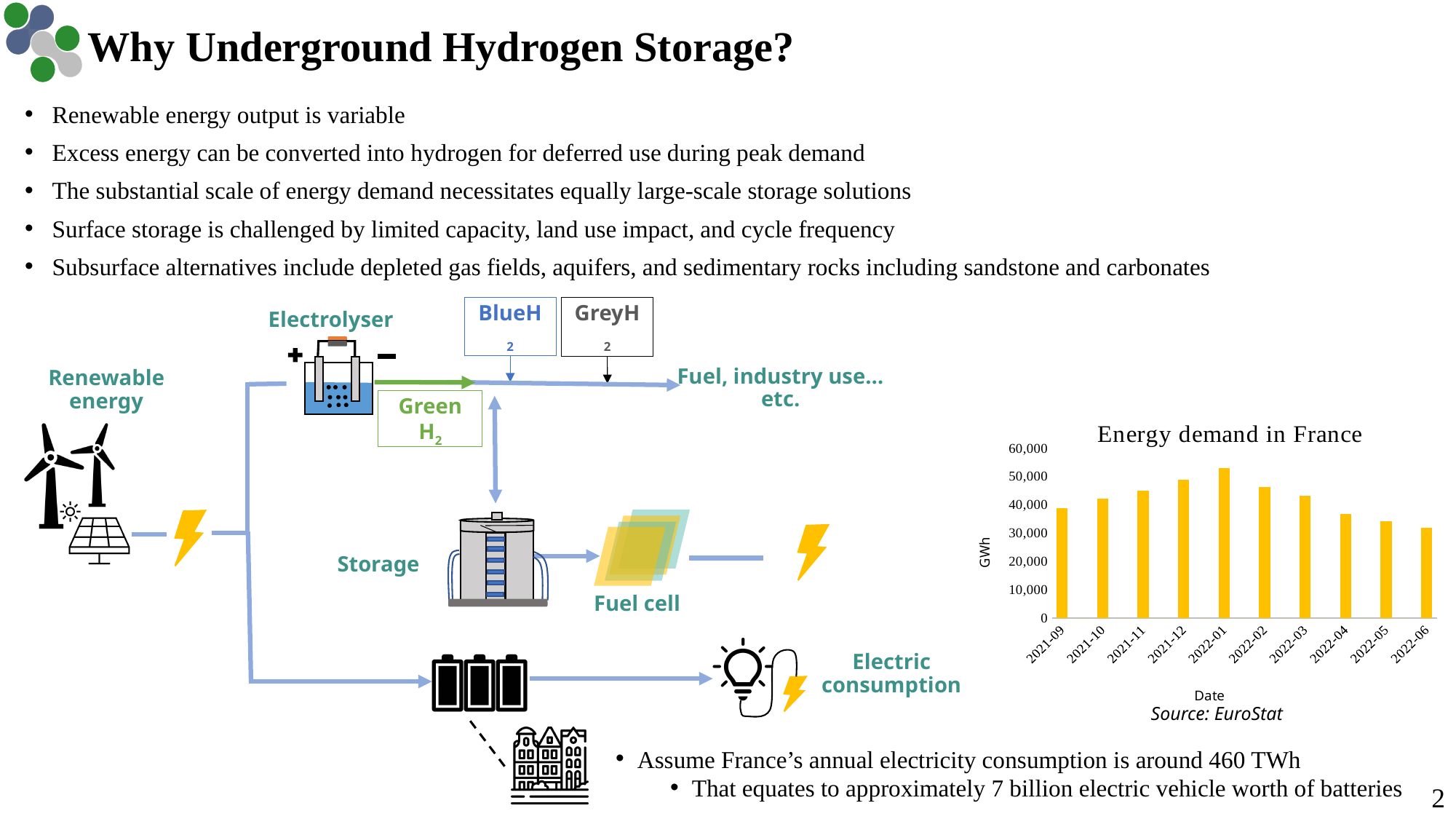
How many months (bars) are plotted in the Energy demand in France chart? 10 What is the title of the chart on the slide? Energy demand in France Which month has higher energy demand, 2021-12 or 2022-04? 2021-12 How does energy demand change from 2022-01 to 2022-06 in the chart? It falls What unit is shown on the y-axis of the Energy demand in France chart? GWh Is the energy demand for 2022-01 greater or less than 50,000 GWh? greater Which month has the highest energy demand in the Energy demand in France chart? 2022-01 Is the energy demand for 2022-04 greater or less than 40,000 GWh? less Is the energy demand for 2021-11 greater or less than 40,000 GWh? greater Which month has the lowest energy demand in the Energy demand in France chart? 2022-06 What type of chart is used to show energy demand in France? bar chart